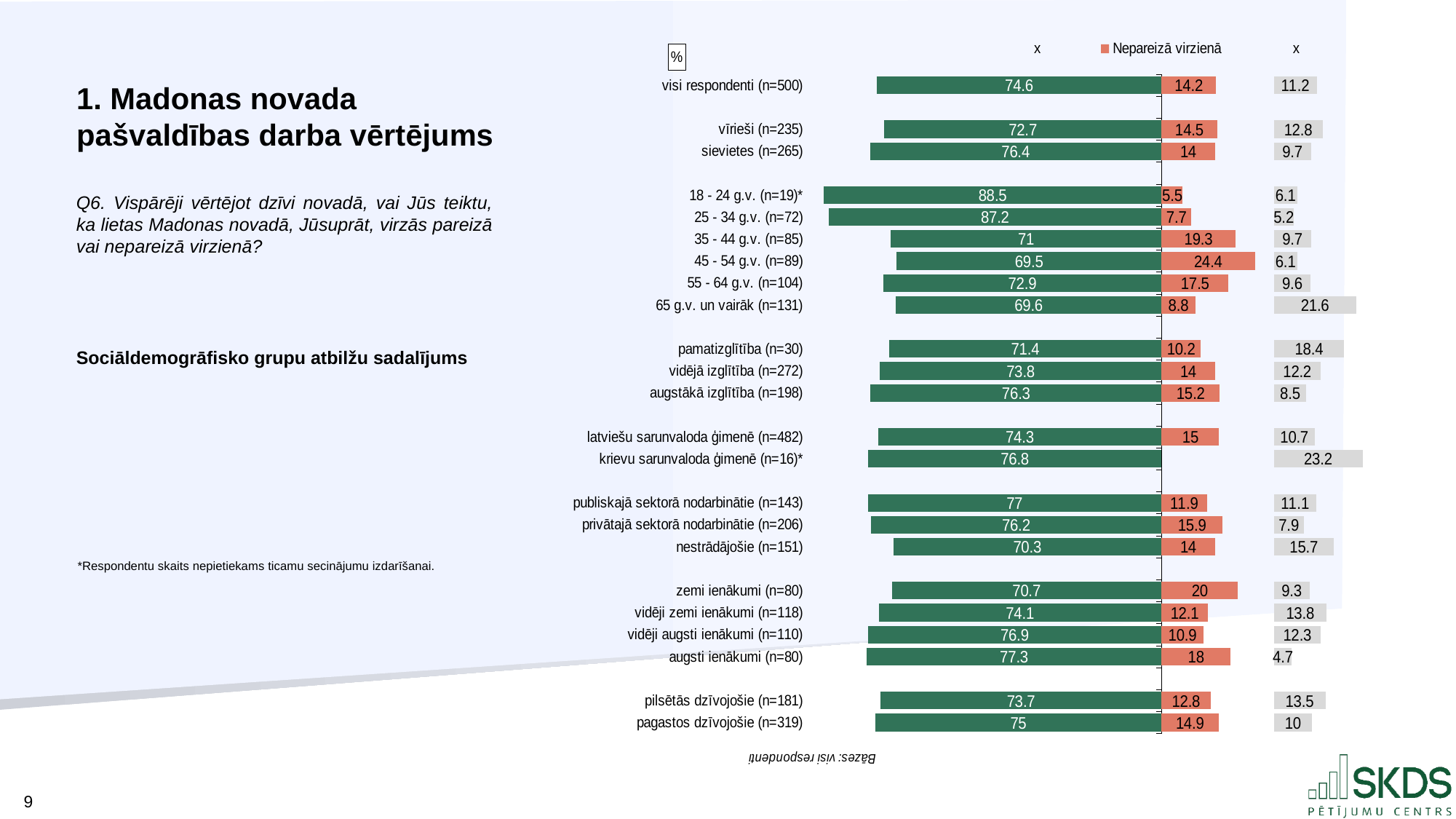
What is the value of the green segment for '18 - 24 g.v. (n=19)*'? 88.5 How many categories (rows) are plotted in the chart? 23 What is the 'Nepareizā virzienā' value for '45 - 54 g.v. (n=89)'? 24.4 What is the value of the grey segment for '65 g.v. un vairāk (n=131)'? 21.6 Which category has the highest 'Nepareizā virzienā' value? 45 - 54 g.v. (n=89) Which has the larger green segment value: 'vīrieši (n=235)' or 'sievietes (n=265)'? sievietes (n=265) Among the categories with a printed 'Nepareizā virzienā' label, which has the lowest value? 18 - 24 g.v. (n=19)* What is the total of the three segments for 'visi respondenti (n=500)'? 100 What kind of chart is shown on the slide? bar chart What is the difference between the green segment value and the 'Nepareizā virzienā' value for 'visi respondenti (n=500)'? 60.4 Which category has the highest value in the green segment? 18 - 24 g.v. (n=19)* What is the 'Nepareizā virzienā' value for 'visi respondenti (n=500)'? 14.2